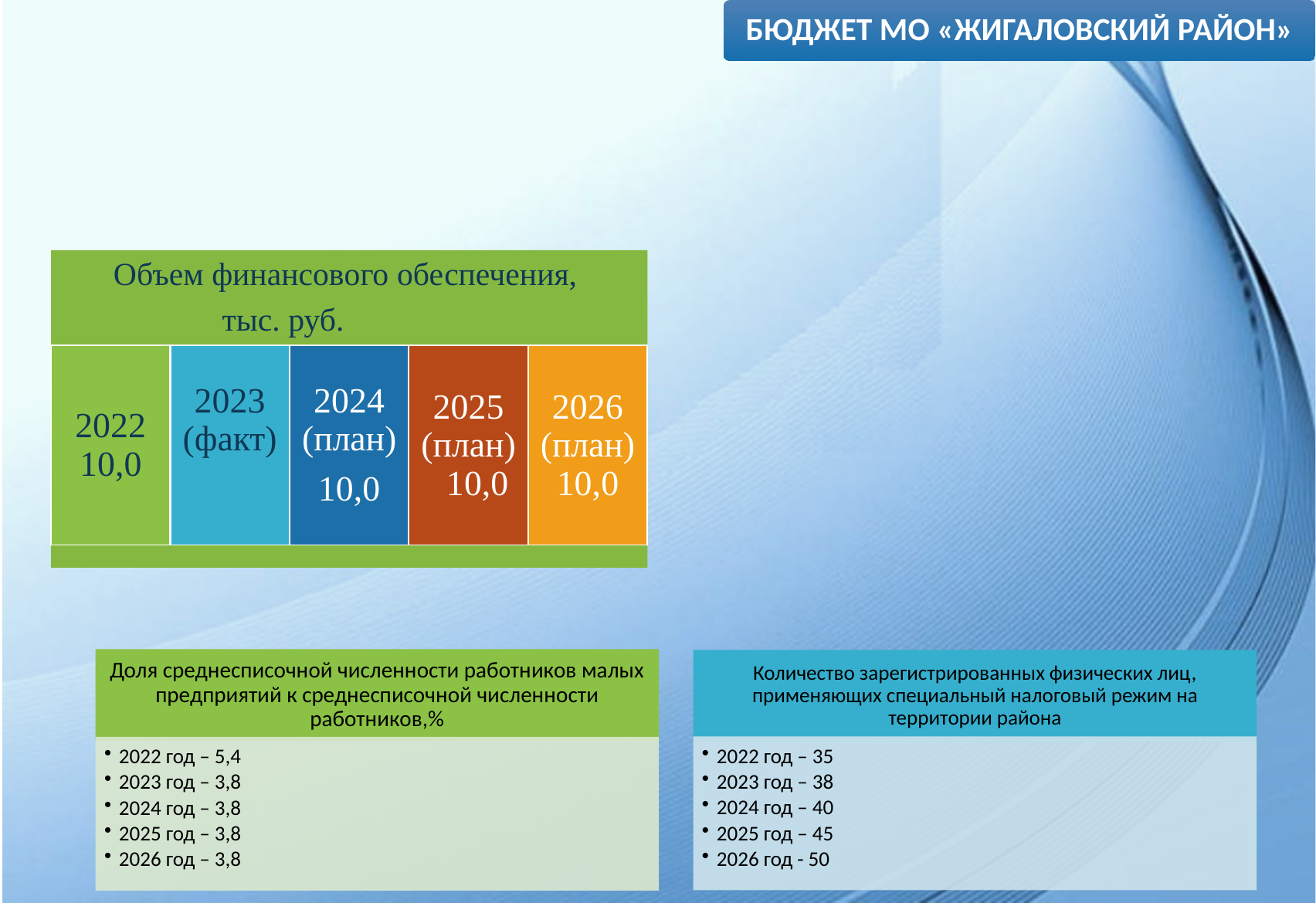
What is the title of the chart with the coloured year blocks? Объем финансового обеспечения, тыс. руб. What is the value for 2025 (план) in the chart 'Объем финансового обеспечения, тыс. руб.'? 10,0 How many year categories are shown in the chart 'Объем финансового обеспечения, тыс. руб.'? 5 What is the value for 2022 in the chart 'Объем финансового обеспечения, тыс. руб.'? 10,0 What is the value for 2024 (план) in the chart 'Объем финансового обеспечения, тыс. руб.'? 10,0 What is the value for 2026 (план) in the chart 'Объем финансового обеспечения, тыс. руб.'? 10,0 In the chart 'Объем финансового обеспечения, тыс. руб.', what unit are the values given in? тыс. руб. In the chart 'Объем финансового обеспечения, тыс. руб.', which year is labelled '(факт)'? 2023